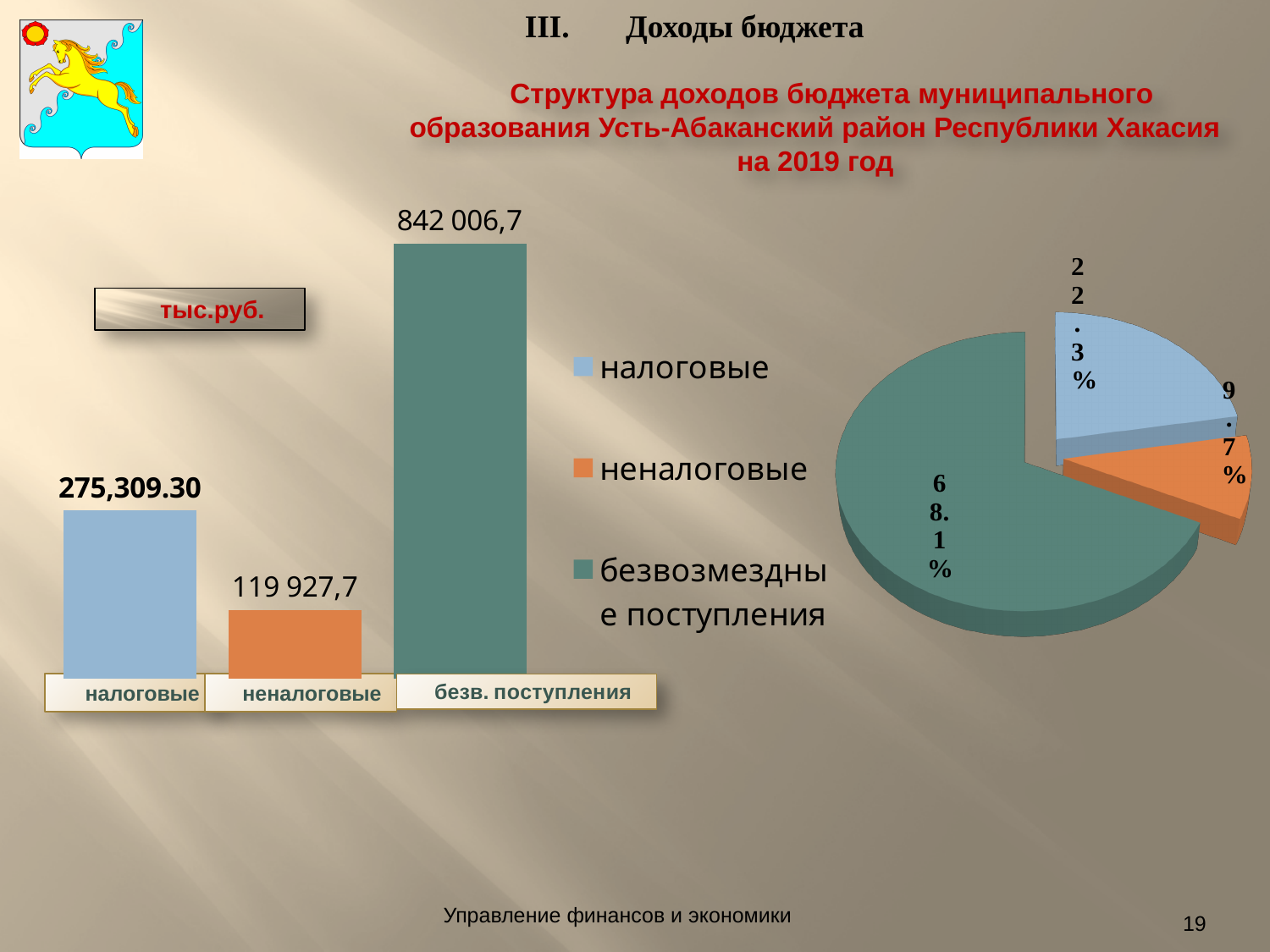
On the bar chart, which category has the lowest value? неналоговые On the pie chart, what share does the налоговые slice have? 22.3% What kind of chart is on the left side of the slide? bar chart On the bar chart, what is the value for налоговые? 275,309.30 On the bar chart, what is the value for неналоговые? 119 927,7 On the pie chart, what share does the безвозмездные поступления slice have? 68.1% How many entries does the legend between the two charts list? 3 On the pie chart, what share does the неналоговые slice have? 9.7% On the bar chart, what is the value for безв. поступления? 842 006,7 On the bar chart, which is larger: налоговые or неналоговые? налоговые On the bar chart, how many categories are shown? 3 On the bar chart, which category has the highest value? безв. поступления